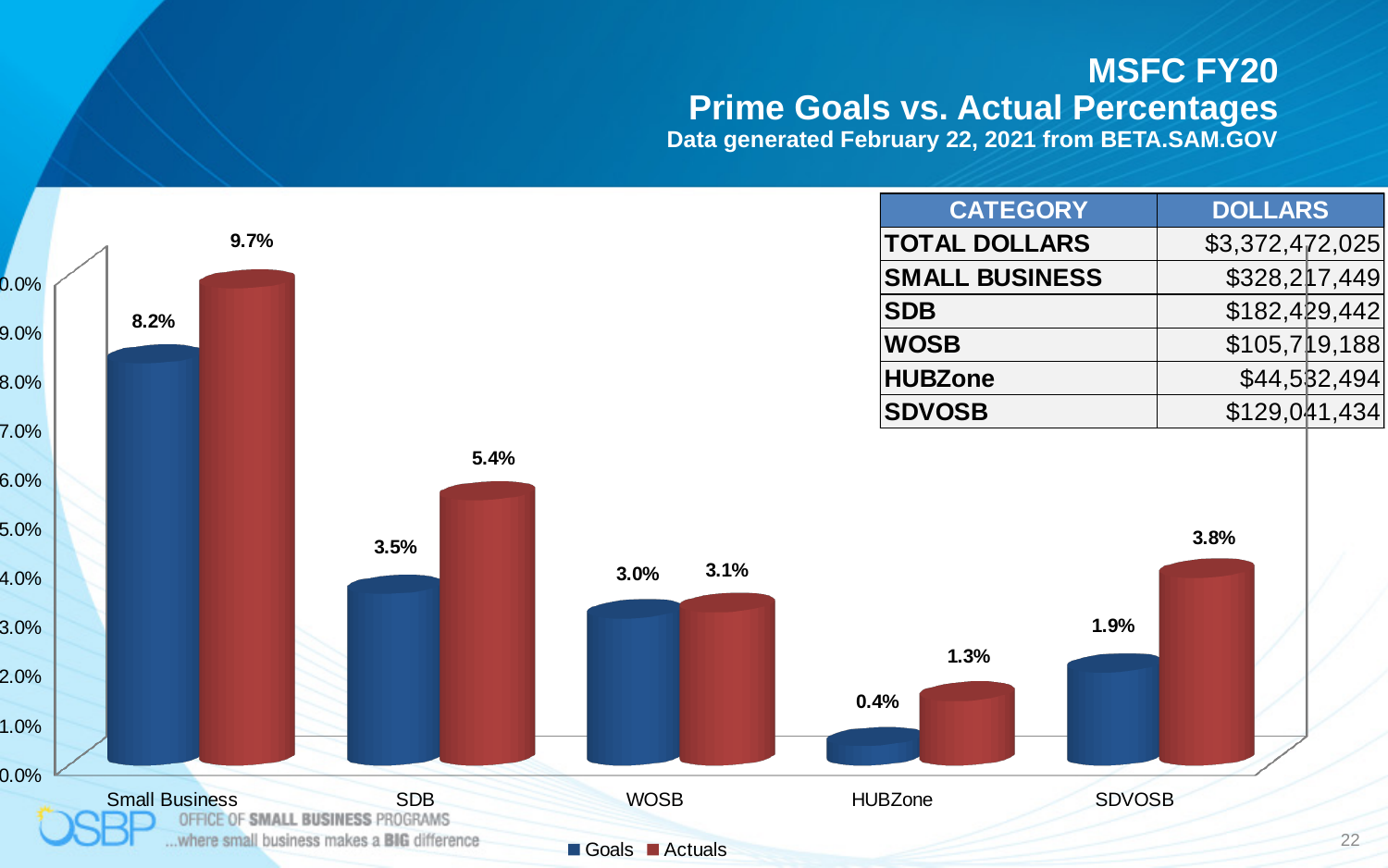
How many categories are shown on the x axis of the chart? 5 What is the Goals value for SDB? 3.5% What is the Goals value for SDVOSB? 1.9% What kind of chart is shown on the slide? Bar chart What is the Actuals value for Small Business? 9.7% Which category has the lowest Goals value? HUBZone Which category has the highest Actuals value? Small Business Which is larger for SDVOSB, the Goals value or the Actuals value? Actuals How many series does the chart legend list? 2 What are the two series named in the chart legend? Goals and Actuals What is the Actuals value for HUBZone? 1.3% What is the difference between the Actuals and Goals values for SDB? 1.9%